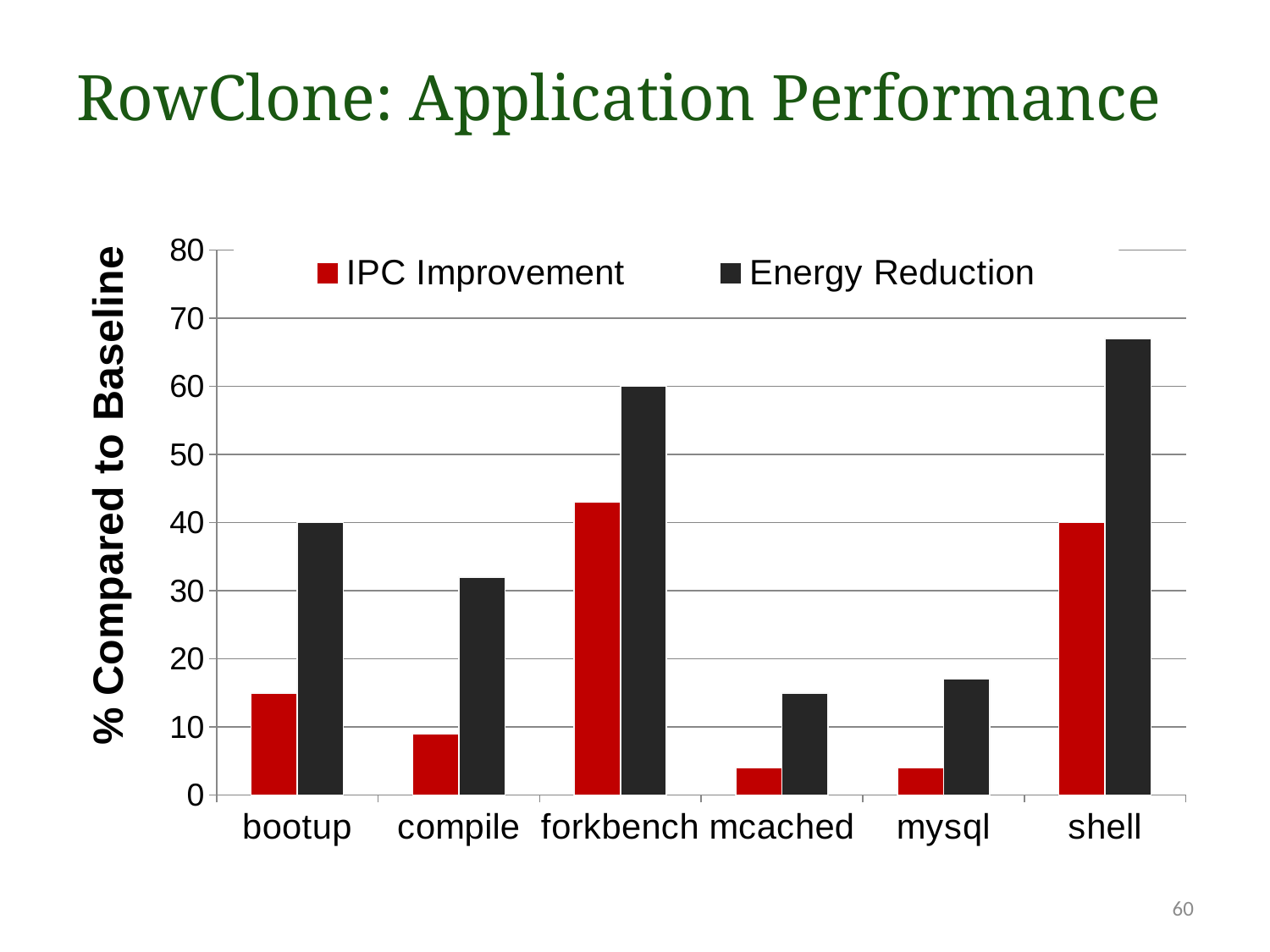
Is the IPC Improvement value for mysql greater or less than 10? less Which colour represents Energy Reduction in the legend? black What is the Energy Reduction value for bootup? 40 What is the Energy Reduction value for forkbench? 60 Is the Energy Reduction value for shell greater or less than 60? greater What kind of chart is shown on the slide? bar chart Which is larger, the IPC Improvement for bootup or for compile? bootup Is the Energy Reduction value for compile greater or less than 30? greater Which application has the highest Energy Reduction? shell How many series does the legend list? 2 How many applications (categories) are shown on the x axis? 6 Which application has the highest IPC Improvement? forkbench